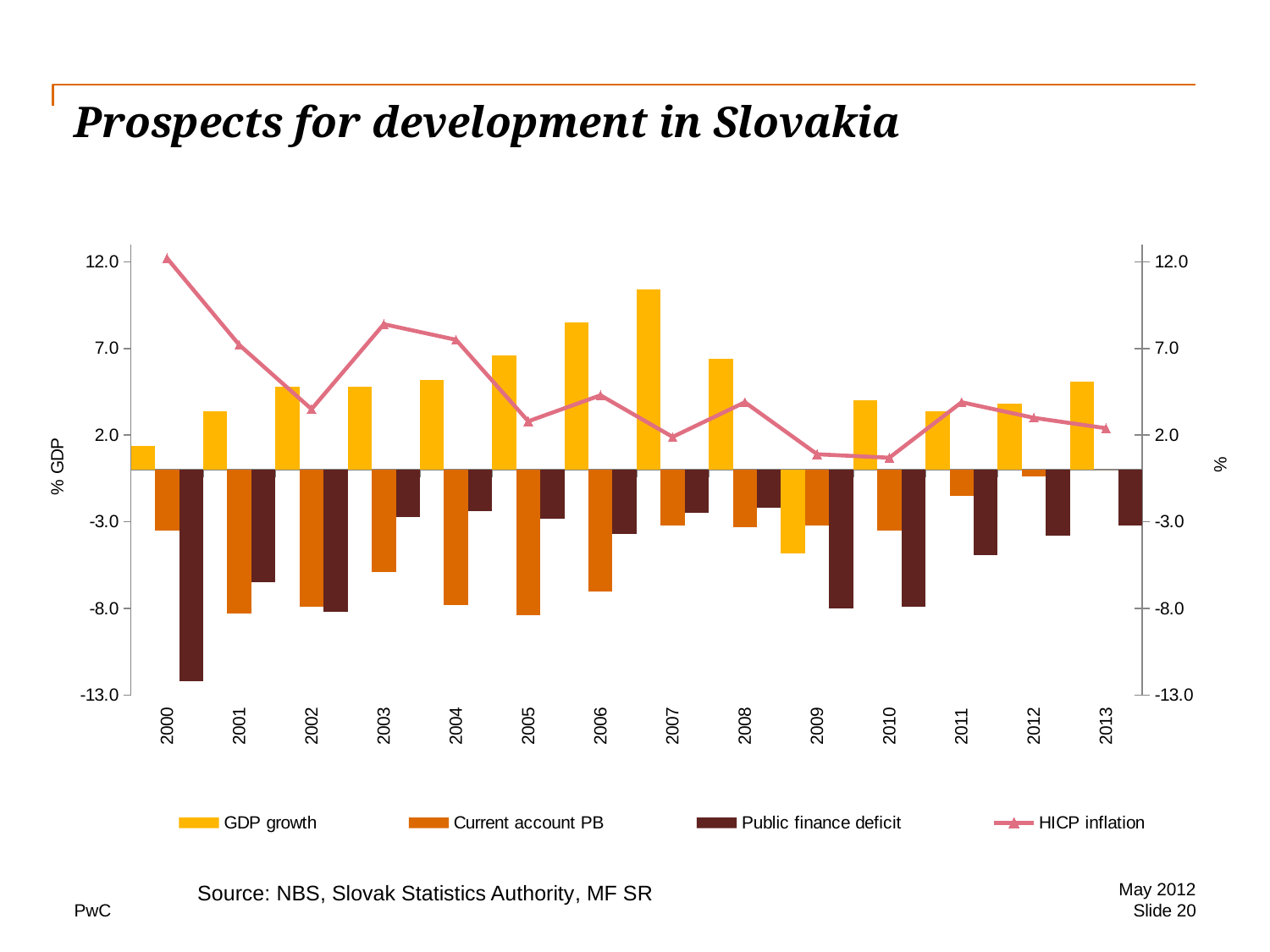
Does HICP inflation rise or fall from 2000 to 2002? It falls How many years are shown on the x axis? 14 In which year is GDP growth highest? 2007 In which year is the public finance deficit bar lowest (most negative)? 2000 What kind of chart is shown on the slide? A combined bar and line chart What is the label on the left vertical axis? % GDP Which year has the larger GDP growth, 2009 or 2010? 2010 Is the public finance deficit value for 2000 greater or less than -8.0? less In which year is HICP inflation highest? 2000 Is the GDP growth value for 2007 greater or less than 7.0? greater How many series does the legend list? 4 In which year is GDP growth lowest? 2009